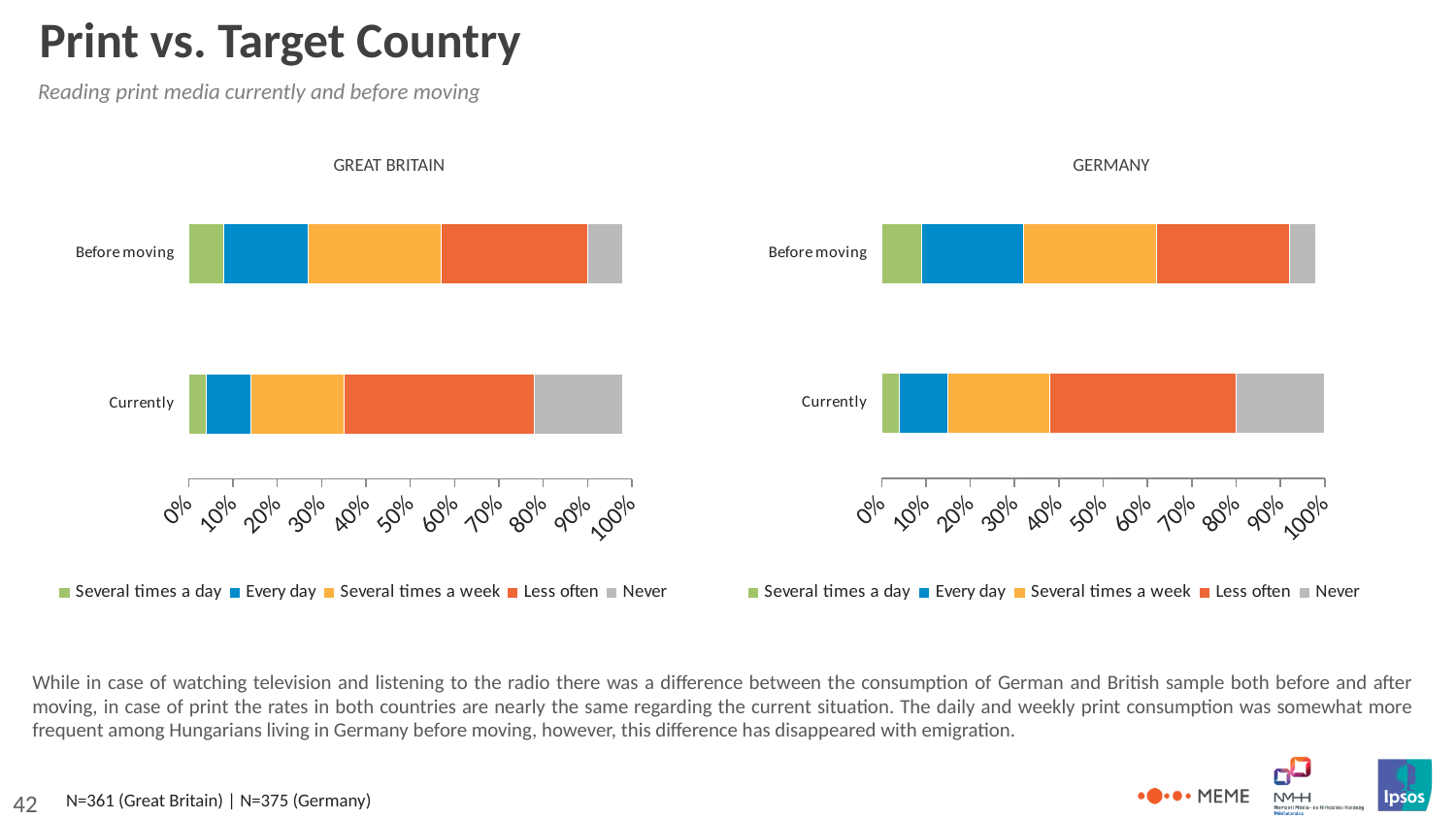
In the GREAT BRITAIN chart, is the 'Never' share for Before moving greater or less than 20%? less How many categories (bars) are shown in the GREAT BRITAIN chart? 2 In the GREAT BRITAIN chart, is the 'Less often' share larger for Before moving or for Currently? Currently Which colour represents 'Never' in the legend of the GERMANY chart? Grey How many series does the legend of the GERMANY chart list? 5 What kind of chart is used for the GREAT BRITAIN chart? Stacked bar chart In the GERMANY chart, is the 'Less often' share for Currently greater or less than 30%? greater In the GREAT BRITAIN chart, is the 'Never' share larger for Before moving or for Currently? Currently In the GERMANY chart, is the 'Never' share for Before moving greater or less than 10%? less In the GERMANY chart, is the 'Every day' share larger for Before moving or for Currently? Before moving